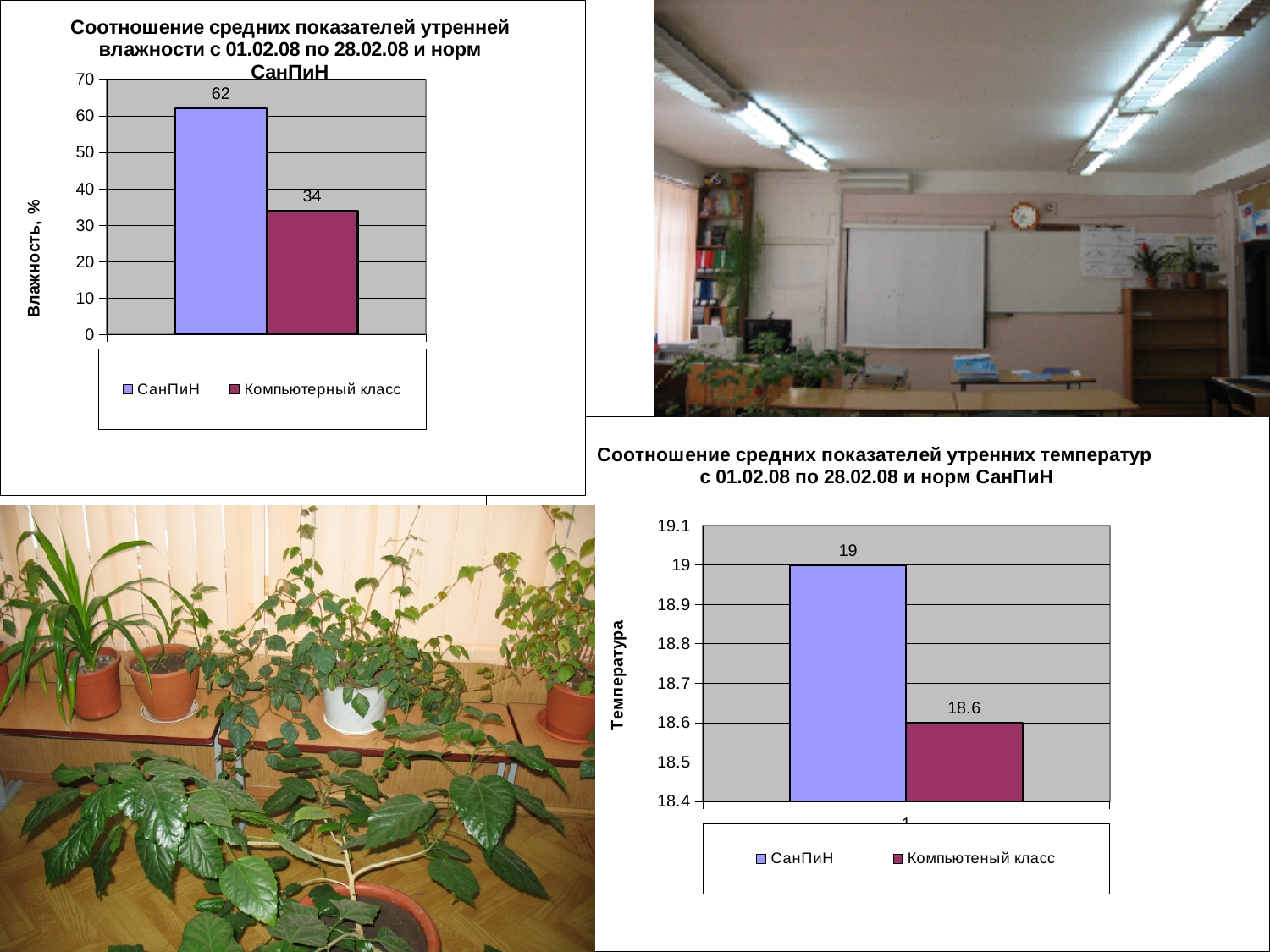
On the humidity chart (top left), which series has the higher value? СанПиН On the humidity chart (top left), what is the value for Компьютерный класс? 34 On the temperature chart (bottom right), what is the value for СанПиН? 19 On the temperature chart (bottom right), what is the value for Компьютеный класс? 18.6 On the humidity chart (top left), what is the y-axis label? Влажность, % On the humidity chart (top left), what is the value for СанПиН? 62 On the temperature chart (bottom right), what is the y-axis label? Температура On the temperature chart (bottom right), which series has the lower value? Компьютеный класс On the temperature chart (bottom right), what is the difference between the СанПиН value and the Компьютеный класс value? 0.4 On the humidity chart (top left), how many series does the legend list? 2 On the humidity chart (top left), what is the difference between the СанПиН value and the Компьютерный класс value? 28 What kind of chart is the temperature chart (bottom right)? Bar chart